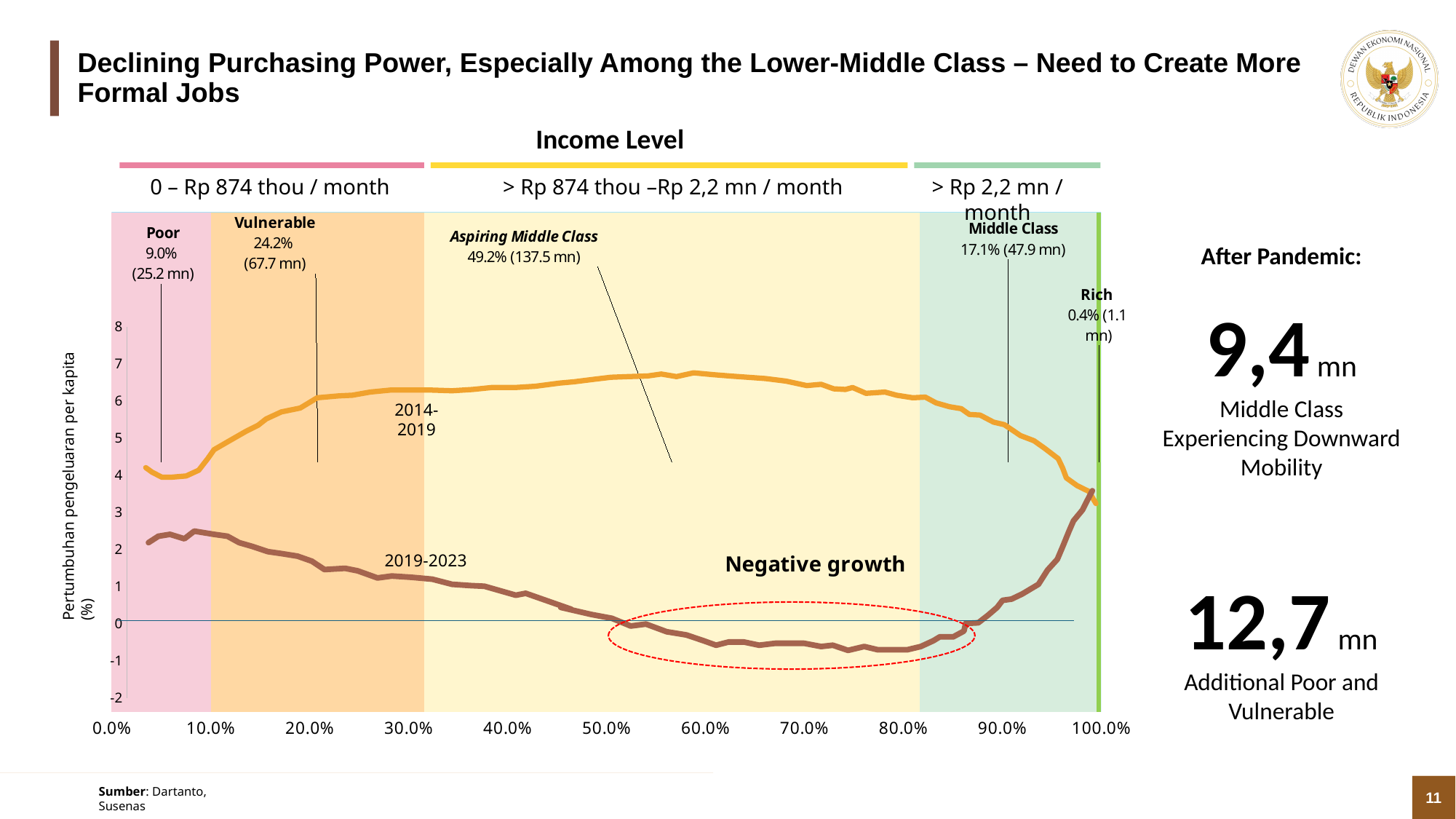
At 50.0% on the x axis, which line is higher: 2014-2019 or 2019-2023? 2014-2019 Does the 2019-2023 line rise or fall between 0.0% and 70.0% on the x axis? fall What share of the population is labelled as Aspiring Middle Class on the chart? 49.2% (137.5 mn) What is the label of the y axis of the chart? Pertumbuhan pengeluaran per kapita (%) What kind of chart is shown on the slide? line chart How many income groups are labelled across the top of the chart (Poor, Vulnerable, etc.)? 5 Is the 2019-2023 line at 70.0% on the x axis greater or less than 0? less Which two periods are labelled on the lines of the chart? 2014-2019 and 2019-2023 What share of the population is labelled as Vulnerable on the chart? 24.2% (67.7 mn) Is the 2014-2019 line at 50.0% on the x axis greater or less than 6? greater How many data series (time periods) are plotted on the chart? 2 What share of the population is labelled as Rich on the chart? 0.4% (1.1 mn)